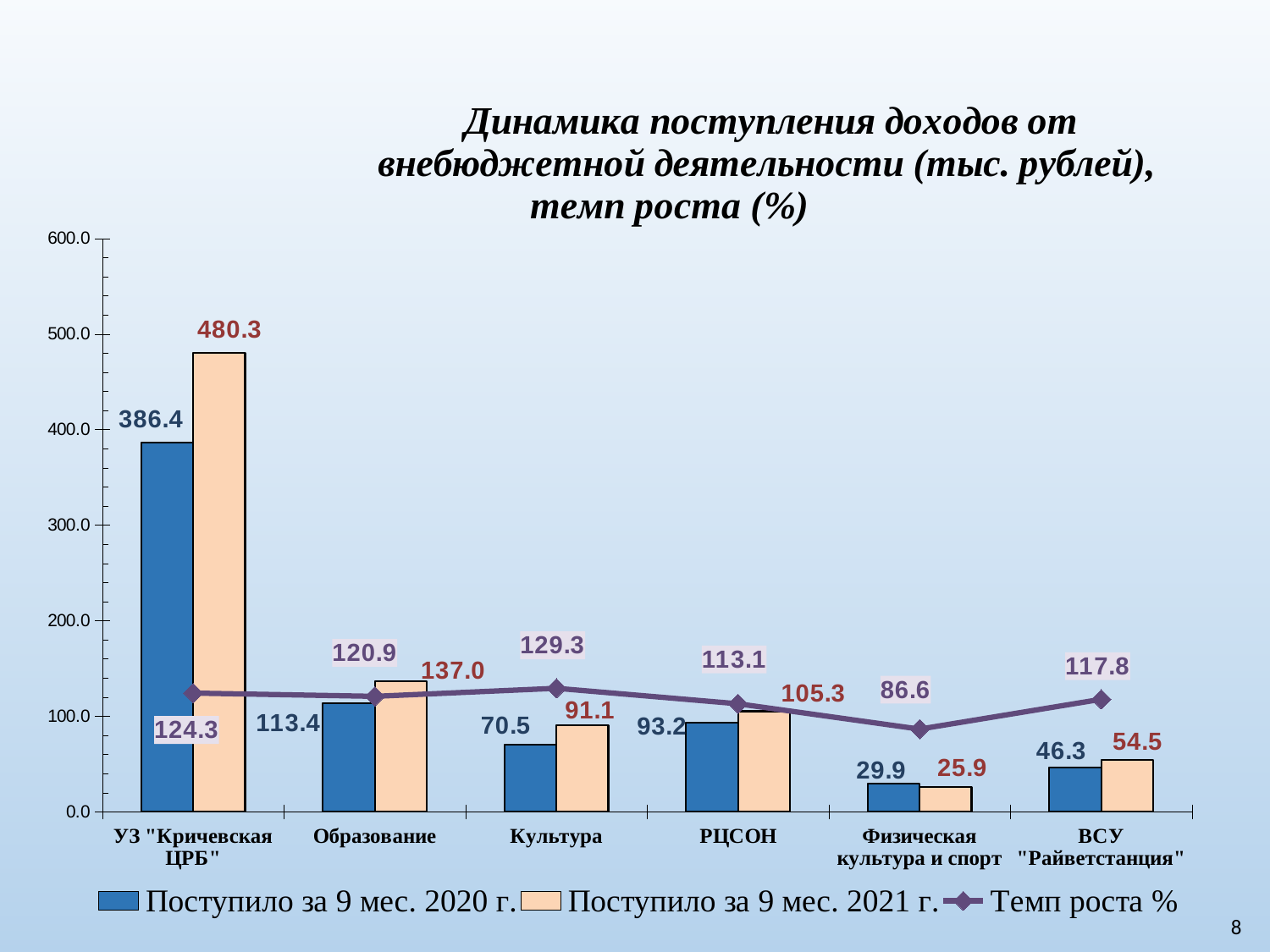
What kind of chart is shown on the slide? Combined bar and line chart For Физическая культура и спорт, which is larger: the value for 9 months of 2020 or for 9 months of 2021? Поступило за 9 мес. 2020 г. What is the "Темп роста %" value for ВСУ "Райветстанция"? 117.8 How many series does the legend list? 3 Is the 2020 value for УЗ "Кричевская ЦРБ" greater or less than 300.0? greater What is the difference between the 2021 and 2020 values for РЦСОН? 12.1 Which category has the lowest "Темп роста %" value? Физическая культура и спорт What is the "Темп роста %" value for Культура? 129.3 How many categories are shown on the x axis? 6 Which category has the highest value for "Поступило за 9 мес. 2021 г."? УЗ "Кричевская ЦРБ" What is the value of "Поступило за 9 мес. 2021 г." for УЗ "Кричевская ЦРБ"? 480.3 What is the value of "Поступило за 9 мес. 2020 г." for Образование? 113.4